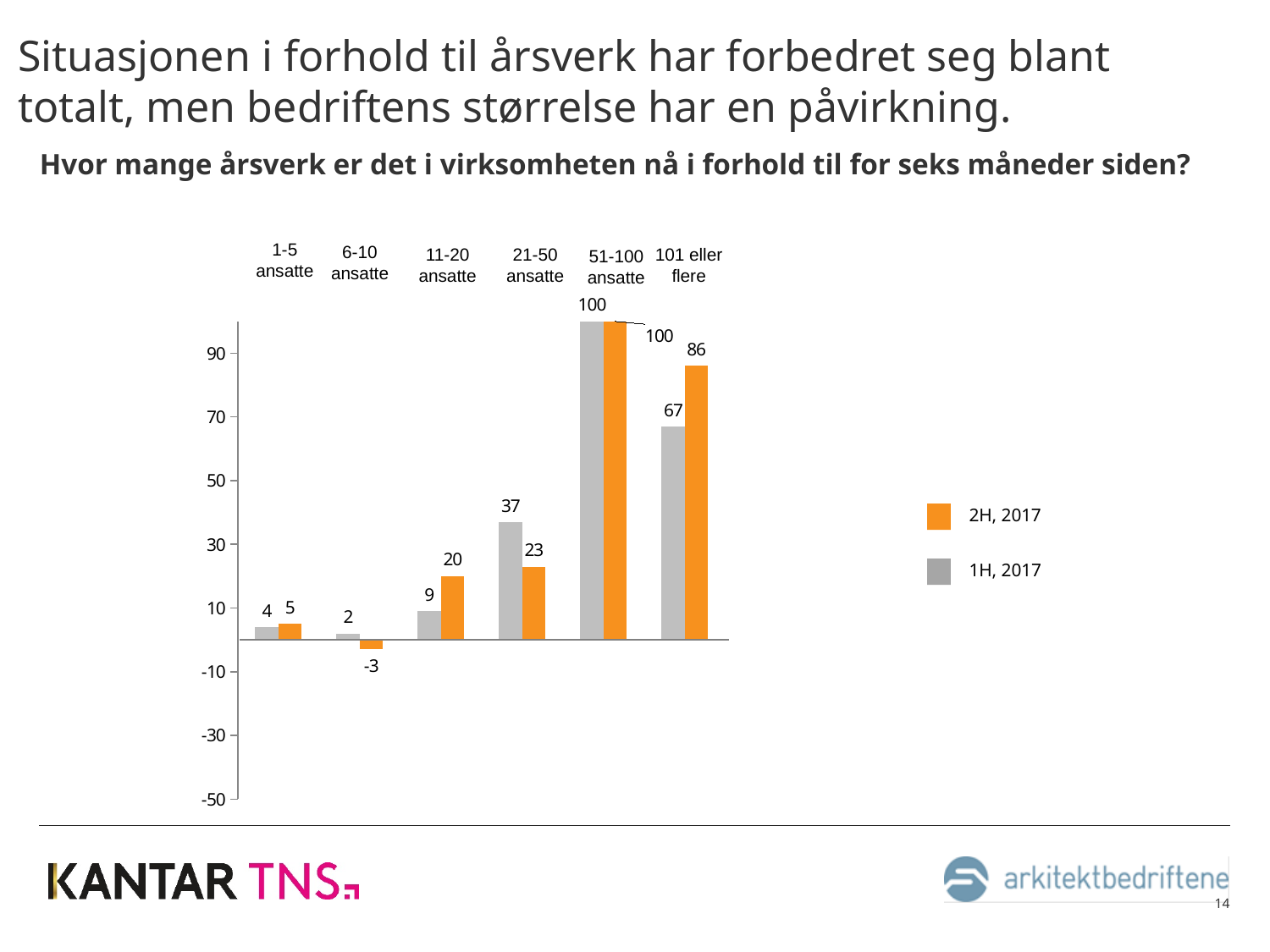
In the 21-50 ansatte category, which series has the larger value, 1H, 2017 or 2H, 2017? 1H, 2017 What is the value for 1H, 2017 in the 21-50 ansatte category? 37 Which category has the lowest value for 2H, 2017? 6-10 ansatte What is the value for 2H, 2017 in the 11-20 ansatte category? 20 What is the difference between the 2H, 2017 and 1H, 2017 values in the 101 eller flere category? 19 How many employee-size categories are shown on the x axis? 6 What is the difference between the 1H, 2017 and 2H, 2017 values in the 21-50 ansatte category? 14 What is the value for 2H, 2017 in the 6-10 ansatte category? -3 How many series does the legend list? 2 What kind of chart is shown on the slide? bar chart Which colour represents the 2H, 2017 series in the legend? orange What is the value for 1H, 2017 in the 101 eller flere category? 67